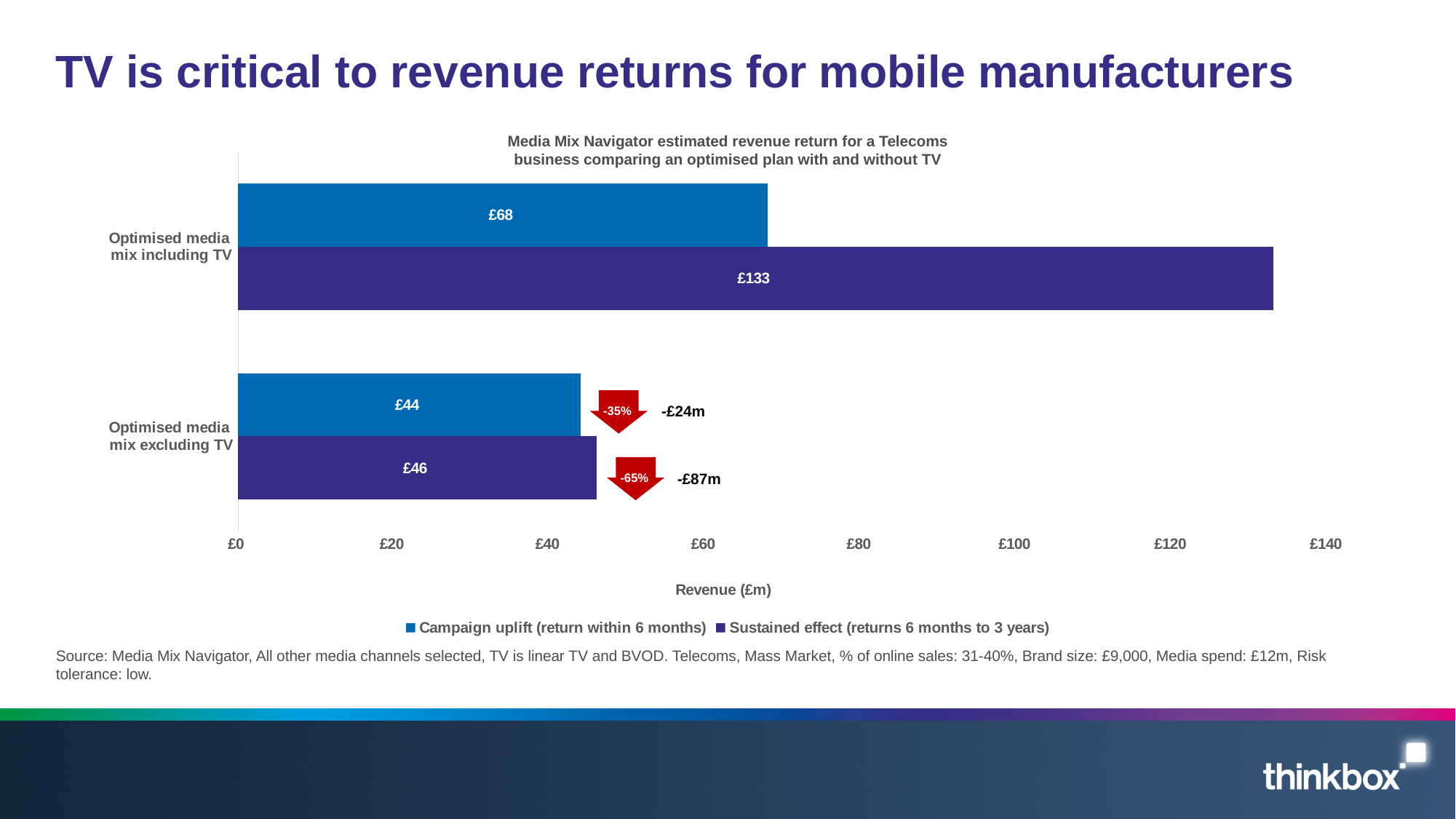
How many series does the legend list? 2 What is the difference between the Campaign uplift values for the media mix including TV and excluding TV? £24 What kind of chart is shown on the slide? Bar chart Which bar has the lowest value on the chart? Campaign uplift, optimised media mix excluding TV What is the Sustained effect value for the optimised media mix excluding TV? £46 How many categories are shown on the vertical axis? 2 Which is larger: the Campaign uplift for the mix including TV or the Sustained effect for the mix excluding TV? Campaign uplift for the mix including TV What is the Sustained effect value for the optimised media mix including TV? £133 Which bar has the highest value on the chart? Sustained effect, optimised media mix including TV What is the difference between the Sustained effect values for the media mix including TV and excluding TV? £87 What is the Campaign uplift value for the optimised media mix excluding TV? £44 What is the Campaign uplift value for the optimised media mix including TV? £68